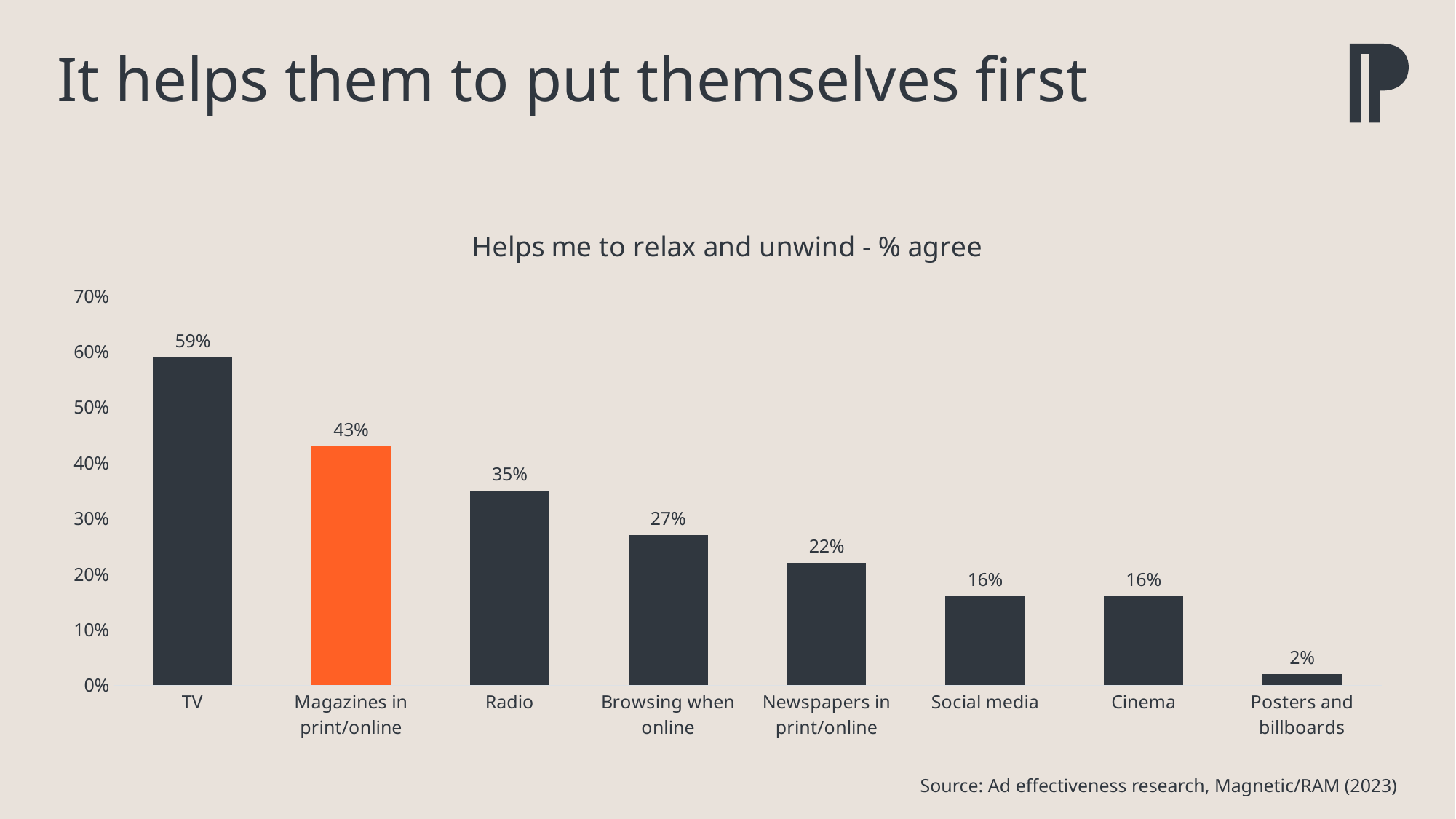
What is the value for Newspapers in print/online? 22% Is the value for Browsing when online greater or less than 30%? less What kind of chart is shown on the slide? Bar chart Which category has the lowest value? Posters and billboards Which is larger, the value for Radio or the value for Cinema? Radio What is the difference between the values for Magazines in print/online and Browsing when online? 16% What is the difference between the values for TV and Radio? 24% How many categories are shown in the chart? 8 What is the value for Magazines in print/online? 43% What is the title of the chart? Helps me to relax and unwind - % agree Which category has the highest value? TV What is the value for TV? 59%